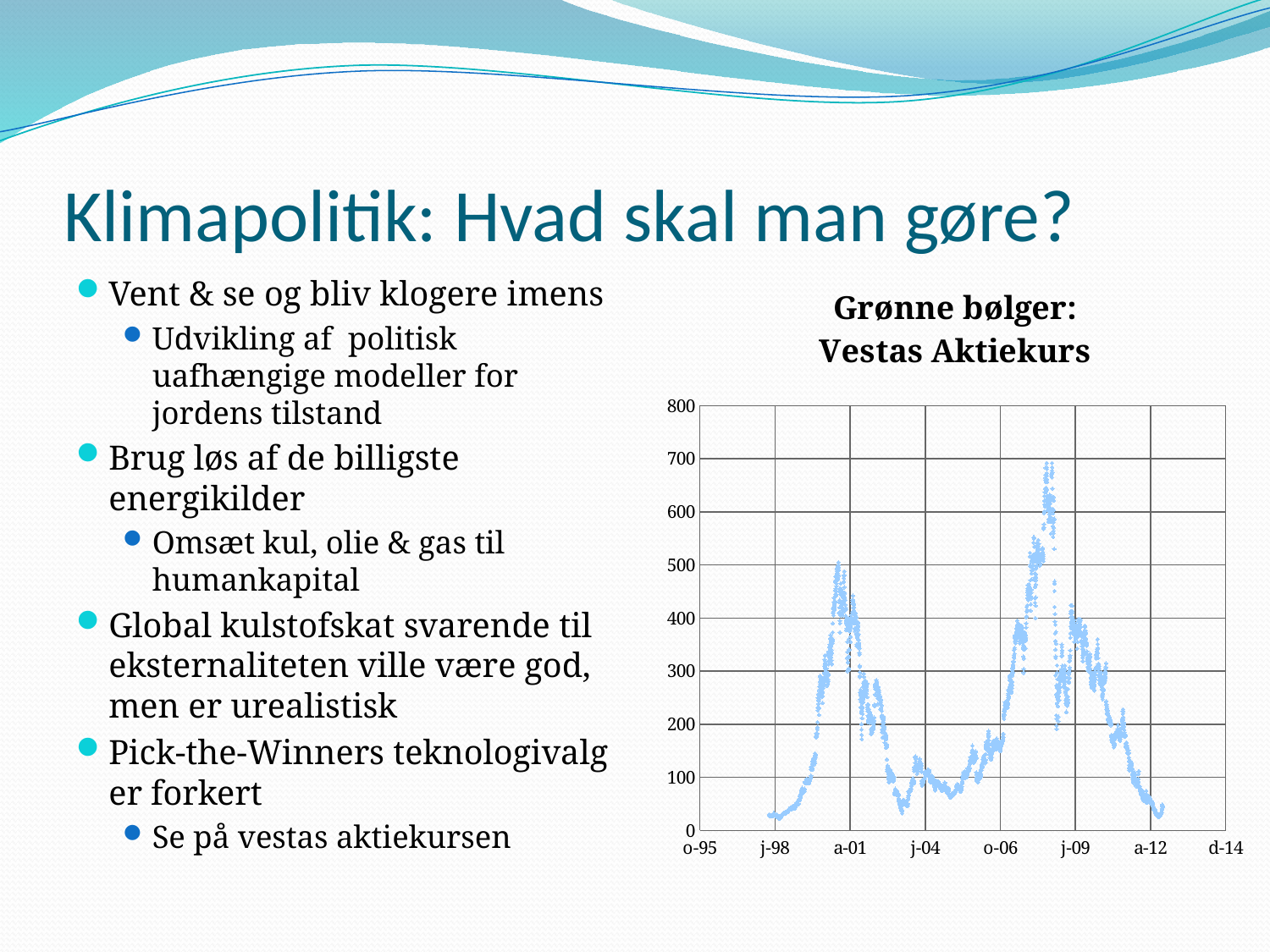
What is the highest value shown on the vertical axis of the chart? 800 Is the peak of the Vestas share price around a-01 greater or less than 600? less Which peak of the Vestas share price is higher: the one around a-01 or the one shortly before j-09? the one shortly before j-09 What is the first label on the horizontal axis of the chart? o-95 Is the Vestas share price at the end of the series, near a-12, greater or less than 100? less Is the highest point of the Vestas share price, reached shortly before j-09, greater or less than 600? greater What is the title of the chart on the slide? Grønne bølger: Vestas Aktiekurs What kind of chart is shown on the slide? scatter chart Does the Vestas share price rise or fall between j-09 and a-12? fall Does the Vestas share price rise or fall between j-98 and a-01? rise